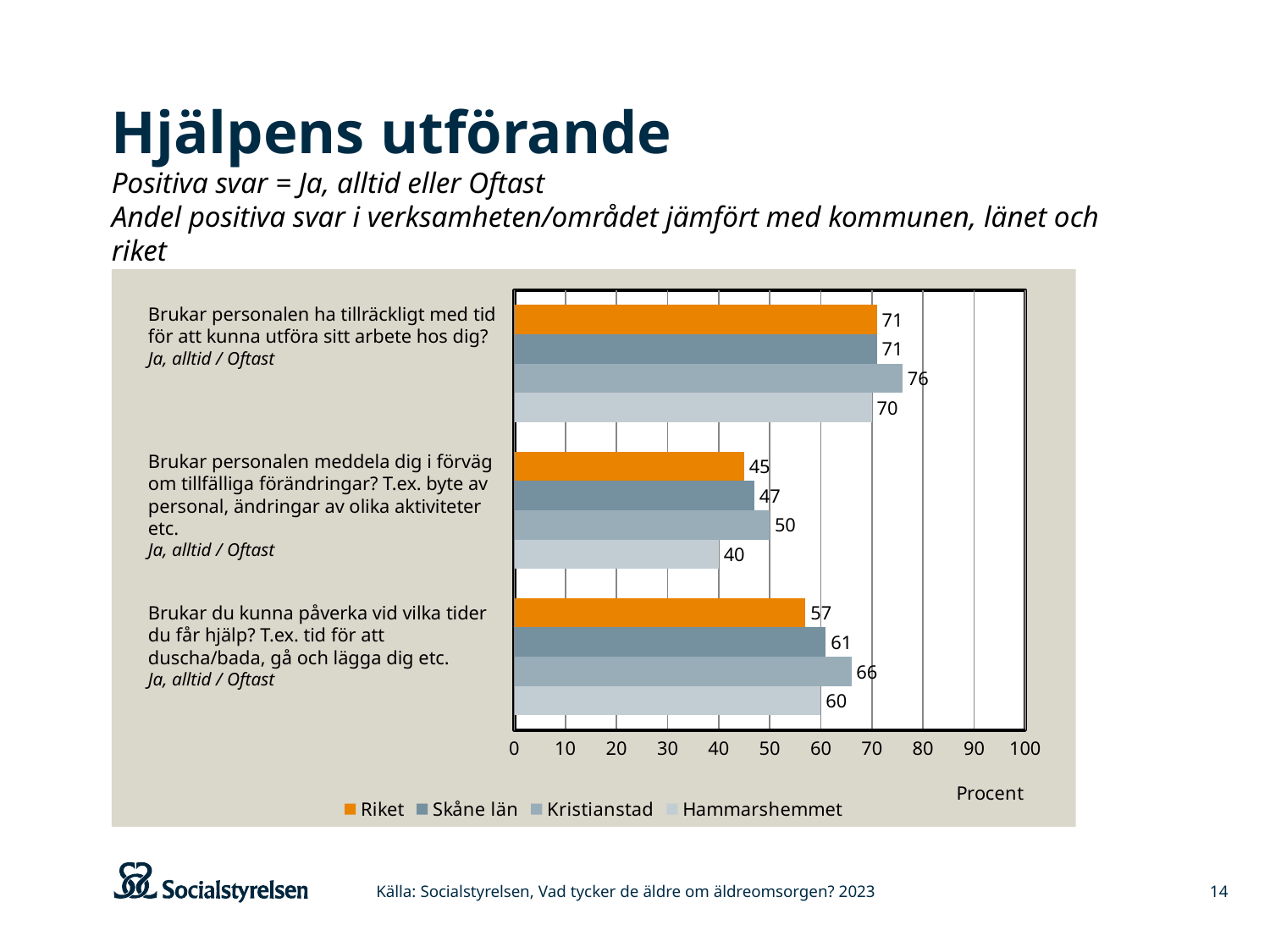
How many series does the legend list? 4 Which series has the lowest value on the question 'Brukar personalen meddela dig i förväg om tillfälliga förändringar?' Hammarshemmet Which series has the highest value on the question 'Brukar personalen ha tillräckligt med tid för att kunna utföra sitt arbete hos dig?' Kristianstad On the question 'Brukar personalen meddela dig i förväg om tillfälliga förändringar?', which is larger: Skåne län or Hammarshemmet? Skåne län What unit label is shown below the x axis of the chart? Procent What is the difference between Kristianstad and Hammarshemmet on the question 'Brukar du kunna påverka vid vilka tider du får hjälp?' 6 What type of chart is shown on the slide? Bar chart What is the value for Hammarshemmet on the question 'Brukar personalen ha tillräckligt med tid för att kunna utföra sitt arbete hos dig?' 70 How many question categories are plotted in the chart? 3 What is the difference between Kristianstad and Riket on the question 'Brukar personalen ha tillräckligt med tid för att kunna utföra sitt arbete hos dig?' 5 What is the value for Riket on the question 'Brukar du kunna påverka vid vilka tider du får hjälp?' 57 What is the value for Kristianstad on the question 'Brukar personalen meddela dig i förväg om tillfälliga förändringar?' 50